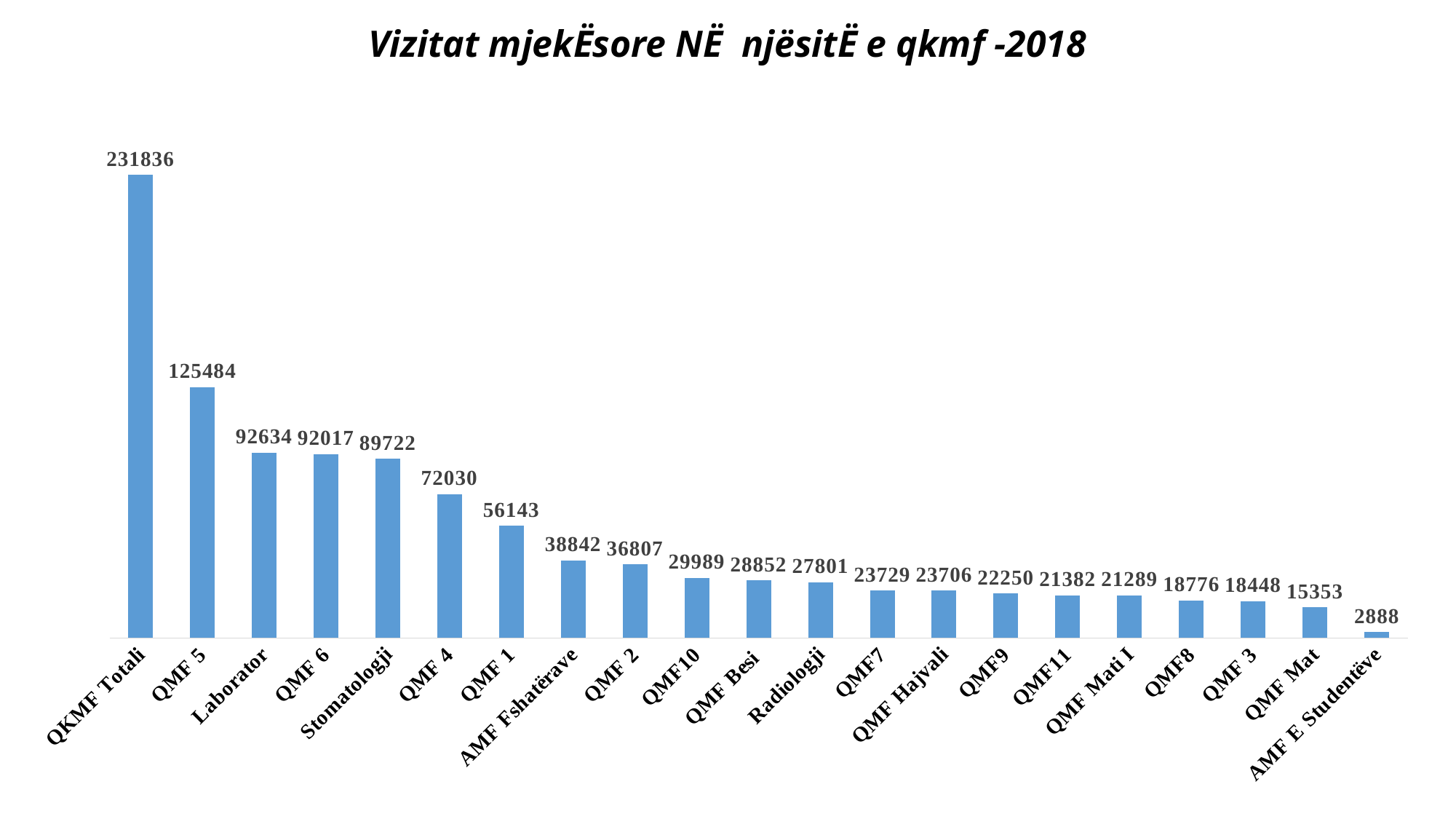
What is the value for QMF Hajvali? 23706 How many categories are shown on the x axis? 21 What is the value for Stomatologji? 89722 What is the value for AMF Fshatërave? 38842 What is the difference between the values for QMF 4 and QMF 1? 15887 What is the difference between the values for QMF 5 and Laborator? 32850 Which category has the highest value? QKMF Totali What kind of chart is shown on the slide? Bar chart What is the value for QKMF Totali? 231836 Which is larger, the value for Stomatologji or the value for QMF 4? Stomatologji Which category has the lowest value? AMF E Studentëve Do the values rise or fall moving from left to right along the x axis? Fall